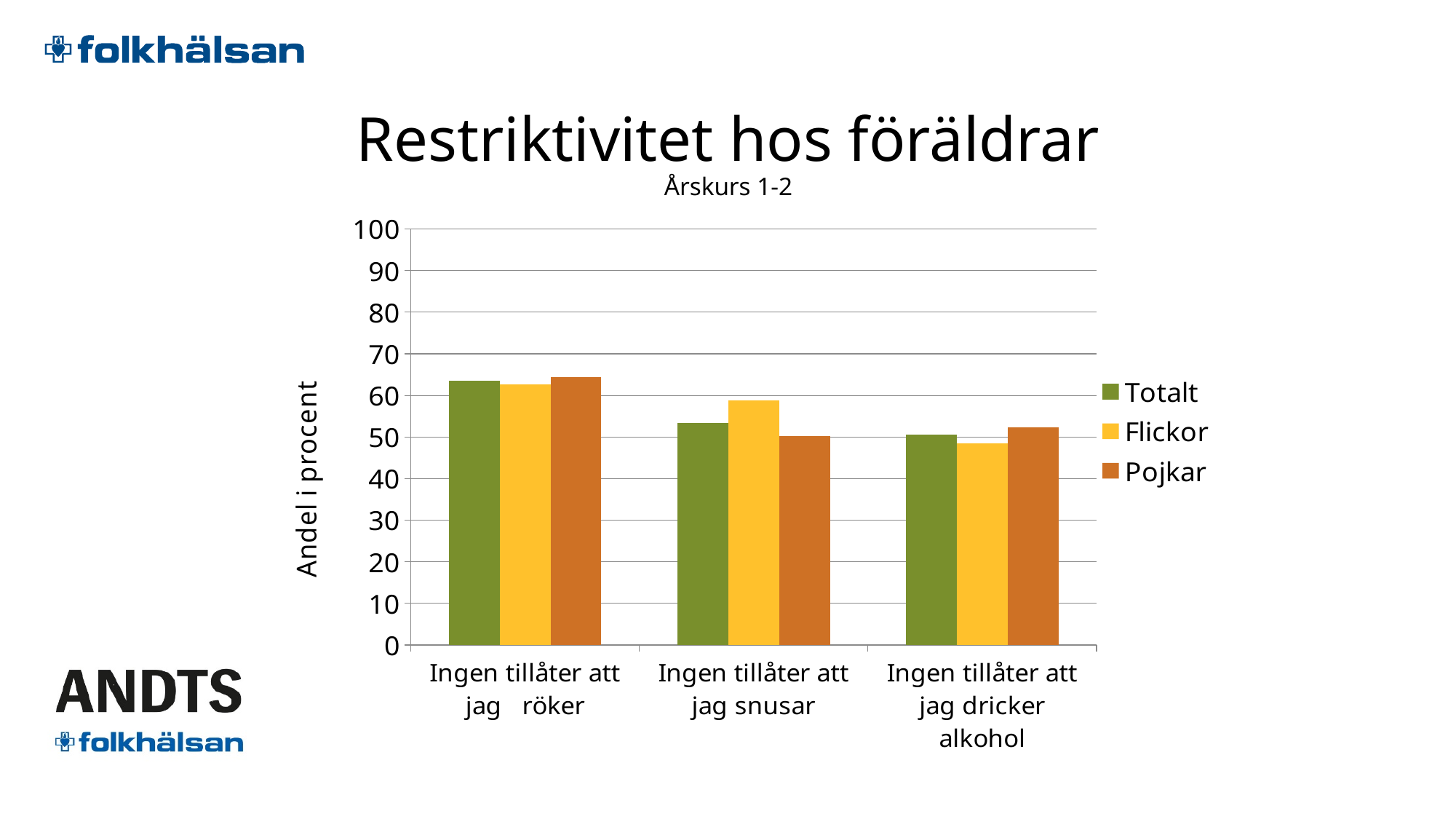
How many series does the legend list? 3 What kind of chart is shown on the slide? bar chart Is the value for Pojkar in the category "Ingen tillåter att jag röker" greater or less than 60? greater Is the value for Totalt in the category "Ingen tillåter att jag dricker alkohol" greater or less than 60? less How many categories are shown on the x axis? 3 What is the title of the vertical axis? Andel i procent Do the Totalt values rise or fall from left to right along the x axis? fall Is the value for Flickor in the category "Ingen tillåter att jag snusar" greater or less than 50? greater For the Totalt series, which is larger: "Ingen tillåter att jag röker" or "Ingen tillåter att jag dricker alkohol"? Ingen tillåter att jag röker In the category "Ingen tillåter att jag snusar", which is larger: Flickor or Pojkar? Flickor In the category "Ingen tillåter att jag snusar", which series has the highest value? Flickor